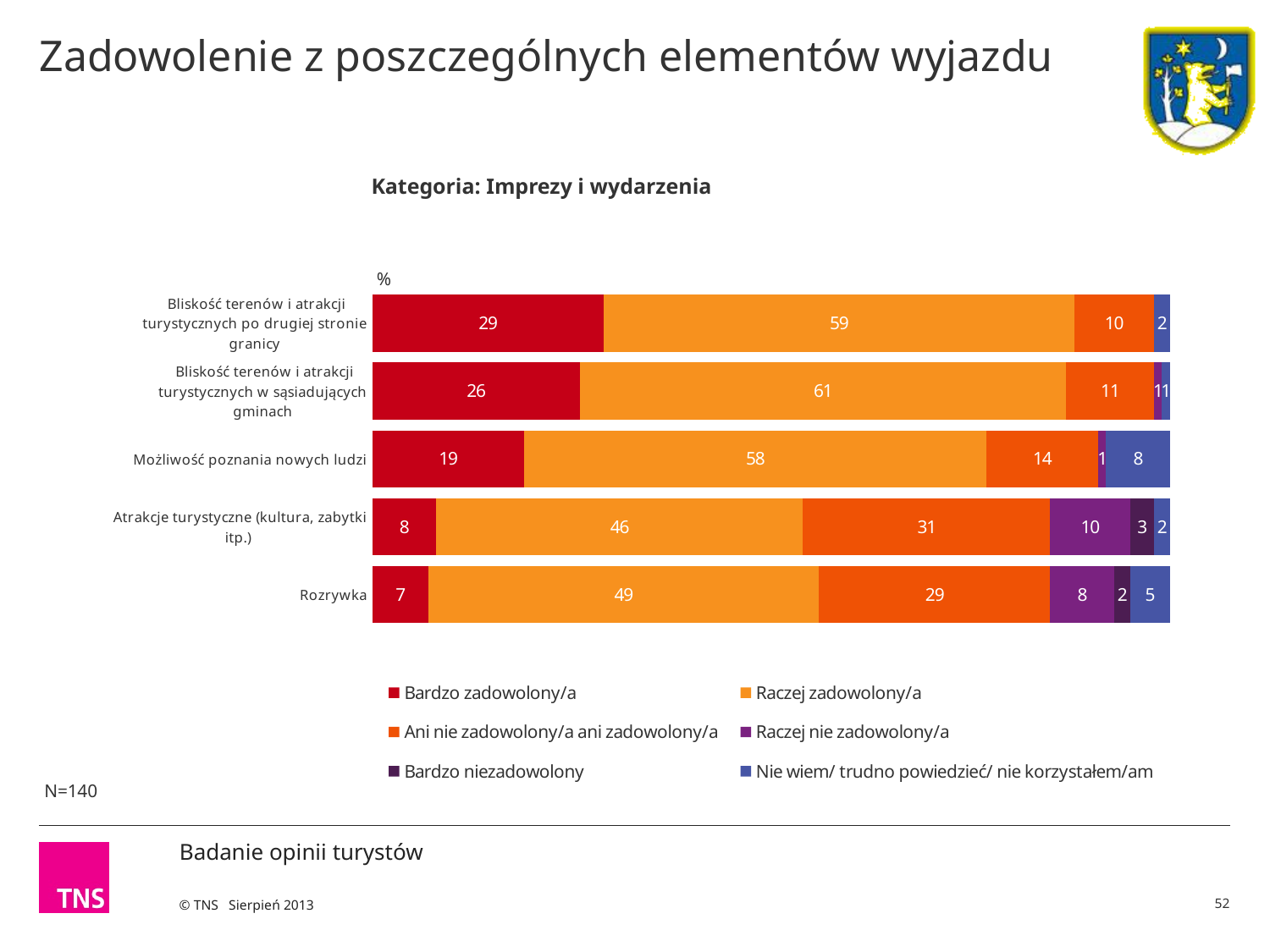
What is the 'Raczej zadowolony/a' value for 'Bliskość terenów i atrakcji turystycznych w sąsiadujących gminach'? 61 How many categories are plotted on the chart? 5 How many series does the legend list? 6 What kind of chart is shown on the slide? stacked bar chart What category heading is shown above the chart? Kategoria: Imprezy i wydarzenia What is the 'Bardzo zadowolony/a' value for 'Rozrywka'? 7 What is the difference between the 'Raczej zadowolony/a' values for 'Bliskość terenów i atrakcji turystycznych w sąsiadujących gminach' and 'Atrakcje turystyczne (kultura, zabytki itp.)'? 15 Which category has the highest 'Bardzo zadowolony/a' value? Bliskość terenów i atrakcji turystycznych po drugiej stronie granicy What is the total of the stacked bar for 'Możliwość poznania nowych ludzi'? 100 Which is larger: the 'Ani nie zadowolony/a ani zadowolony/a' value for 'Możliwość poznania nowych ludzi' or for 'Rozrywka'? Rozrywka Which category has the lowest 'Bardzo zadowolony/a' value? Rozrywka What is the 'Ani nie zadowolony/a ani zadowolony/a' value for 'Atrakcje turystyczne (kultura, zabytki itp.)'? 31